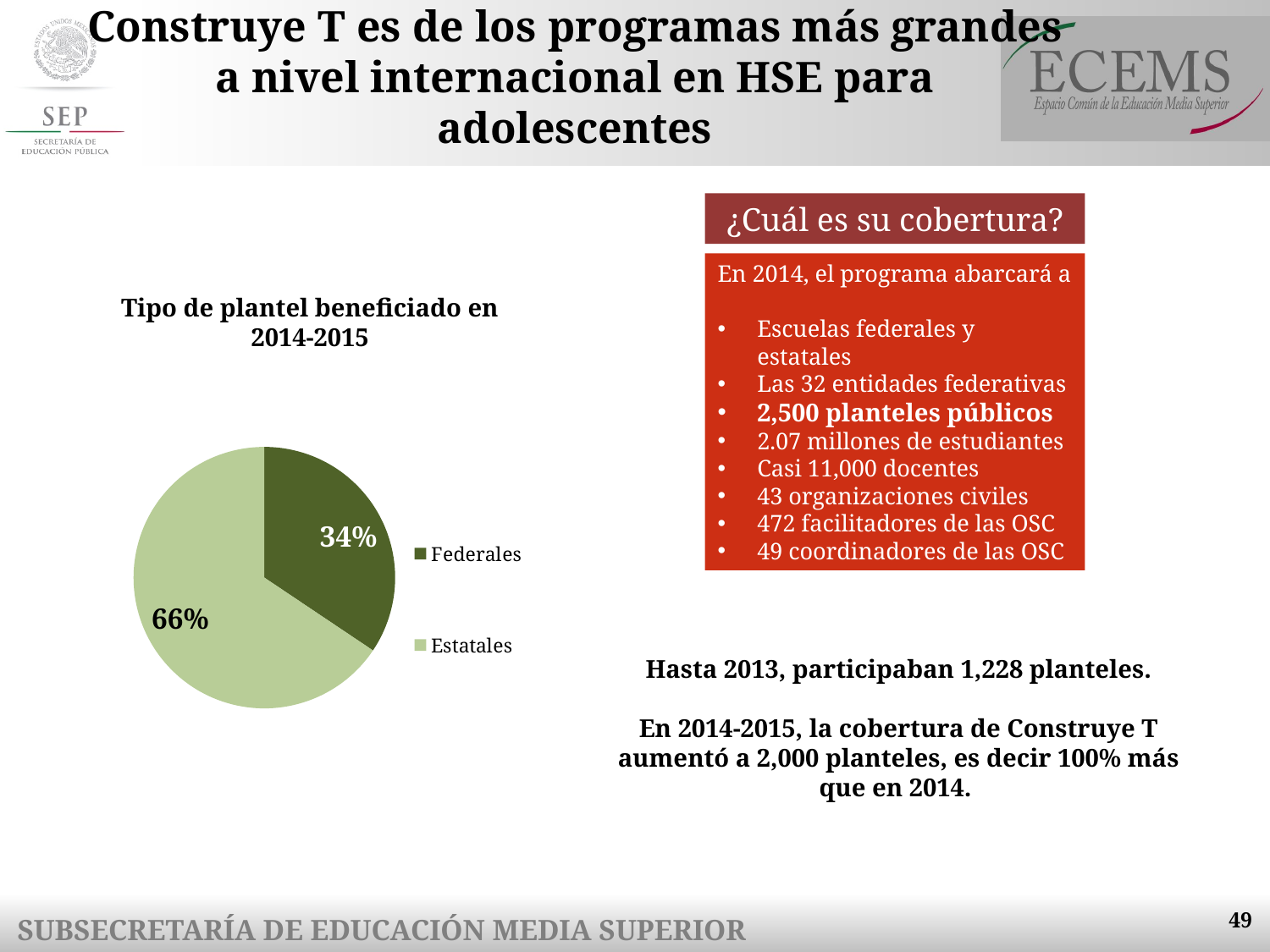
Which category has the largest slice of the pie? Estatales Which is larger, the share for Federales or the share for Estatales? Estatales What is the title of the chart? Tipo de plantel beneficiado en 2014-2015 What kind of chart is shown on the slide? pie chart Which category has the smallest slice of the pie? Federales How many categories does the pie chart show? 2 What share of the pie does Federales represent? 34% What is the difference in percentage points between Estatales and Federales? 32% How many entries does the legend list? 2 Which legend entry is shown in the darker green colour? Federales What share of the pie does Estatales represent? 66%